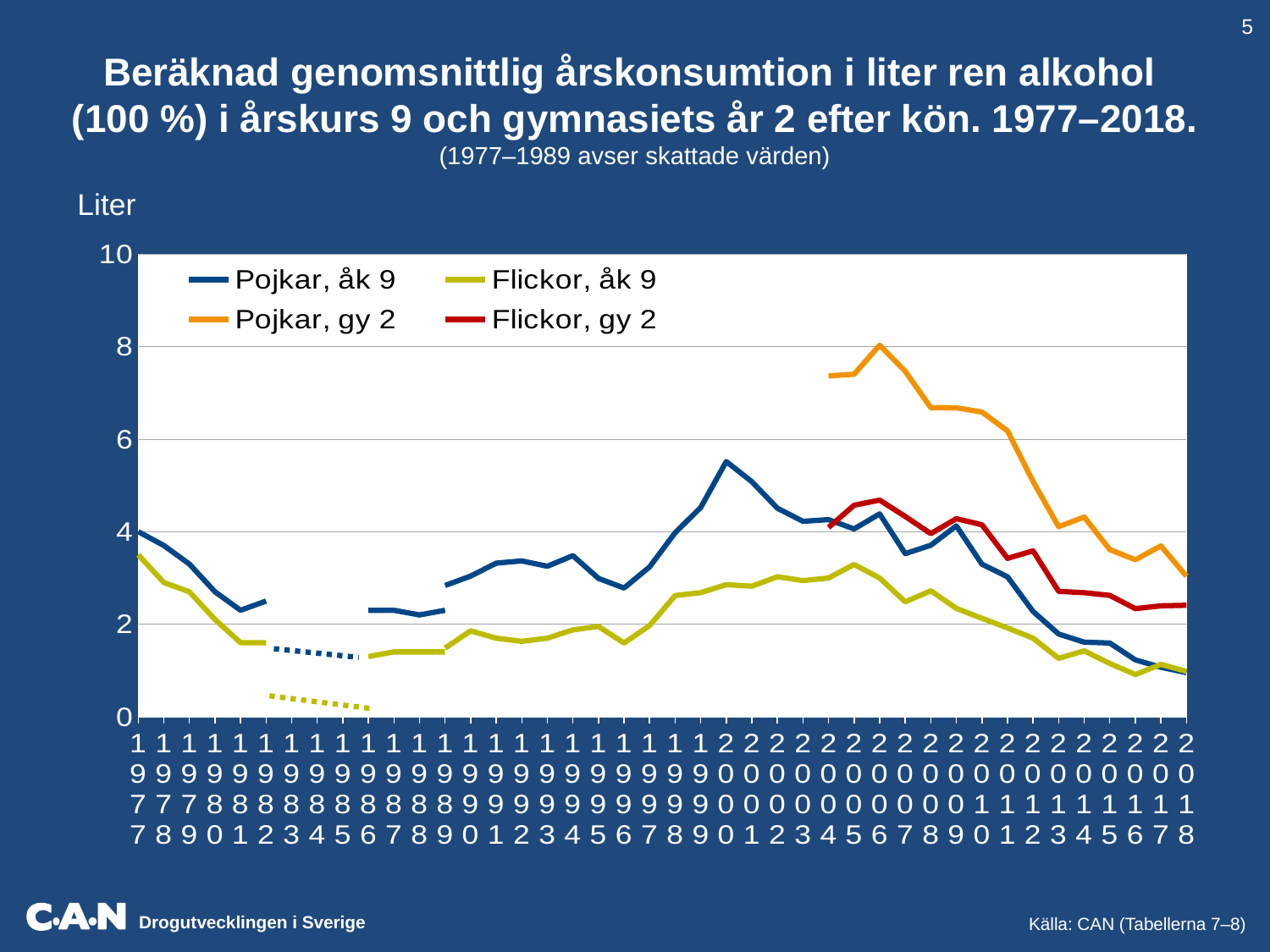
Is the value for Flickor, åk 9 in 2018 greater or less than 2? less What unit is shown on the y axis label? Liter Is the value for Flickor, gy 2 in 2018 greater or less than 2? greater Which series reaches the highest value anywhere on the chart? Pojkar, gy 2 In 1977, which is higher: Pojkar, åk 9 or Flickor, åk 9? Pojkar, åk 9 In 2018, which is higher: Pojkar, gy 2 or Pojkar, åk 9? Pojkar, gy 2 What kind of chart is shown on the slide? line chart Is the value for Pojkar, åk 9 in 2000 greater or less than 4? greater Does the Pojkar, gy 2 series rise or fall from 2005 to 2018? fall How many series does the legend list? 4 Which series are listed in the legend? Pojkar, åk 9; Pojkar, gy 2; Flickor, åk 9; Flickor, gy 2